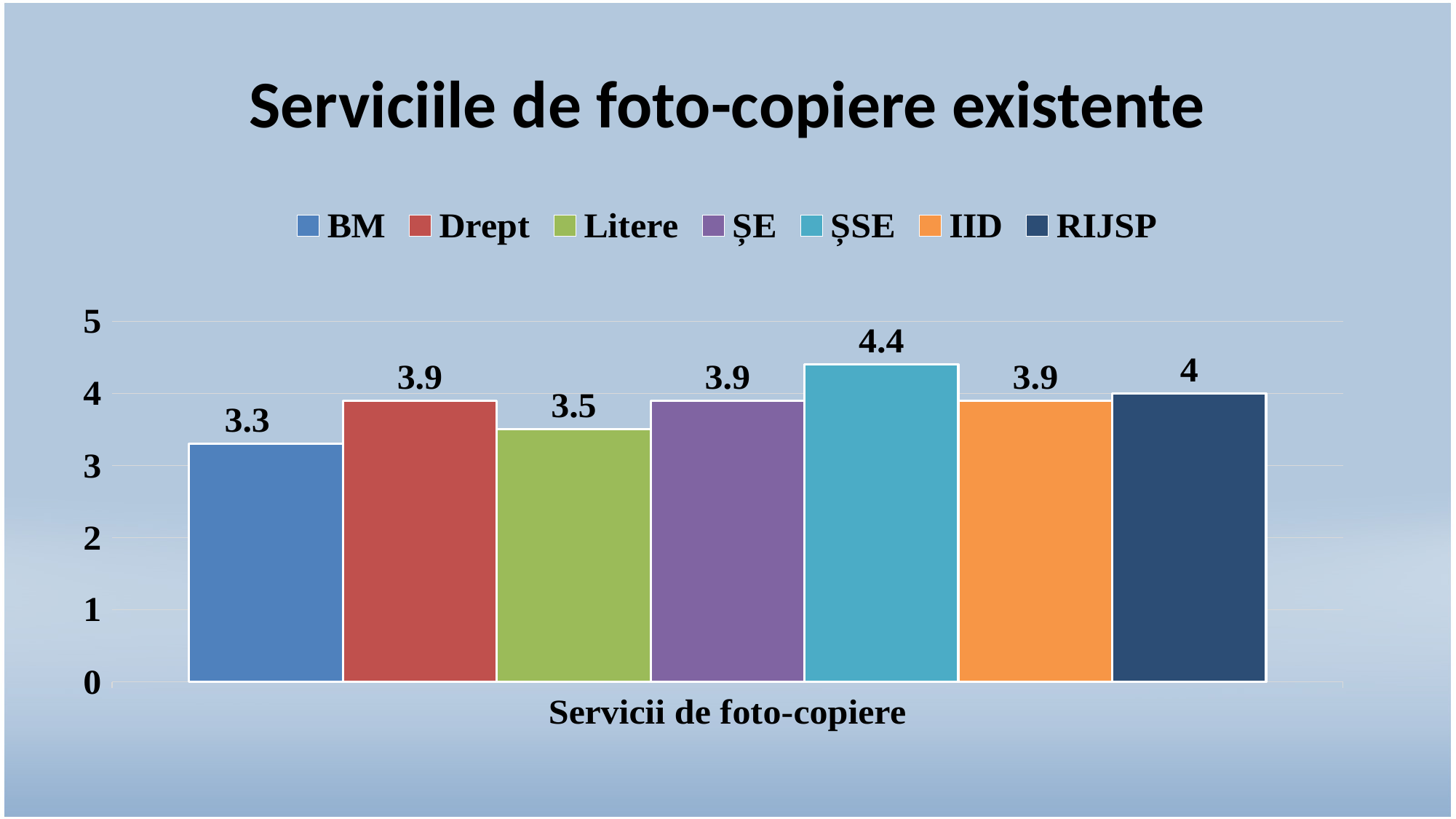
What is the title of the chart? Serviciile de foto-copiere existente What kind of chart is shown on the slide? bar chart Which series has the highest value? ȘSE Is the value for Drept greater or less than 3? greater What is the value for BM? 3.3 What is the value for RIJSP? 4 Which is larger, the value for RIJSP or the value for Litere? RIJSP What is the difference between the values for ȘSE and BM? 1.1 How many series does the legend list? 7 Which series has the lowest value? BM What is the value for ȘSE? 4.4 What is the value for Litere? 3.5